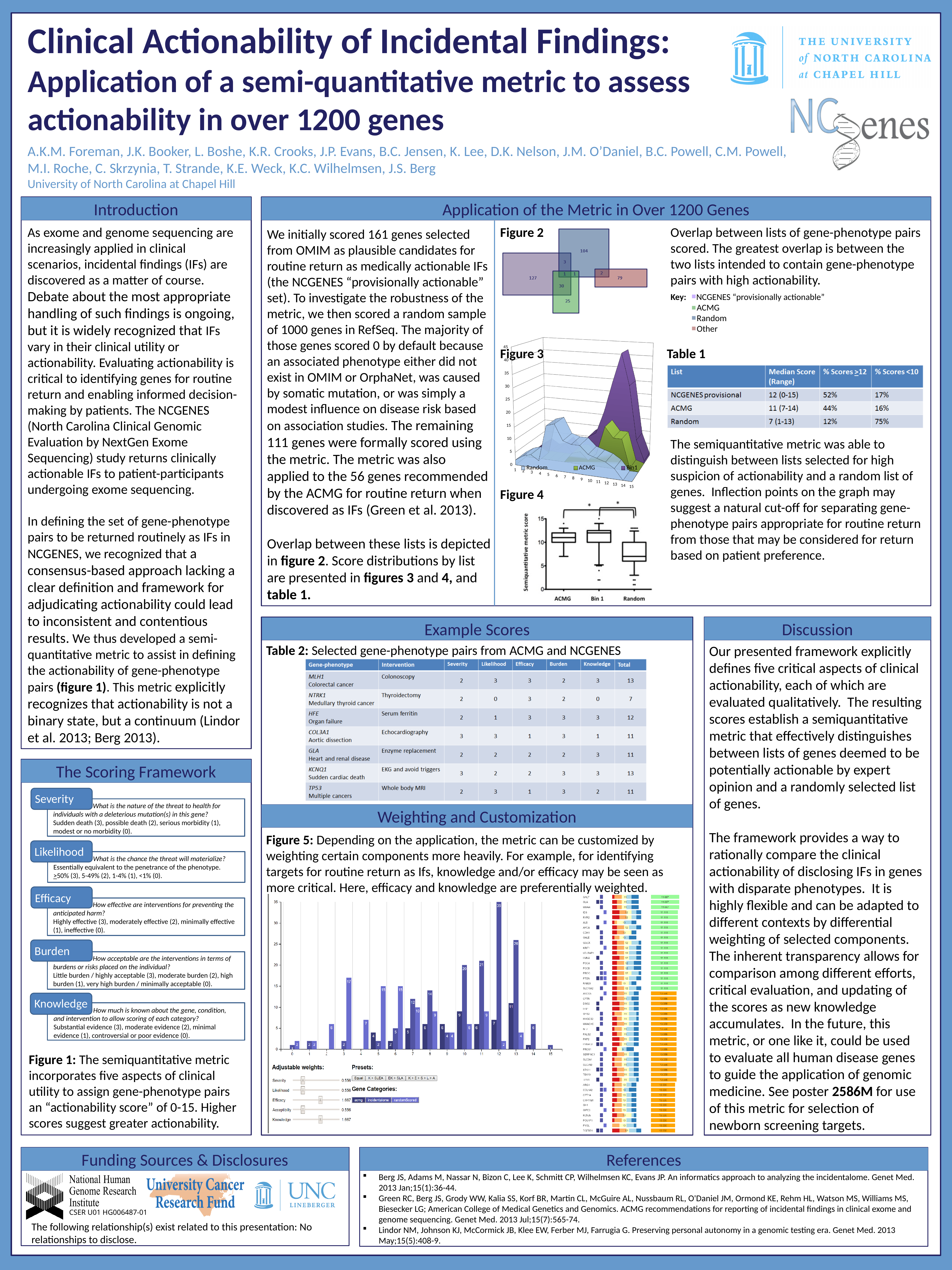
How many series does the legend of Figure 3 list? 3 In Figure 5, is the tallest bar greater or less than 30? greater In Figure 5, what is the difference between the tallest bar at score 12 and the taller bar at score 13? 7 In Figure 5, what is the value of the taller bar at score 13? 28 What is the largest number printed in any region of Figure 2? 127 How many groups are shown on the x axis of Figure 4? 3 In Figure 4, which group has the lowest median semiquantitative metric score? Random What kind of chart is shown in Figure 5? bar chart What kind of chart is Figure 4? box plot How many entries does the key of Figure 2 list? 4 In Figure 5, at which x-axis score does the tallest bar occur? 12 In Figure 5, what is the value of the tallest bar? 35